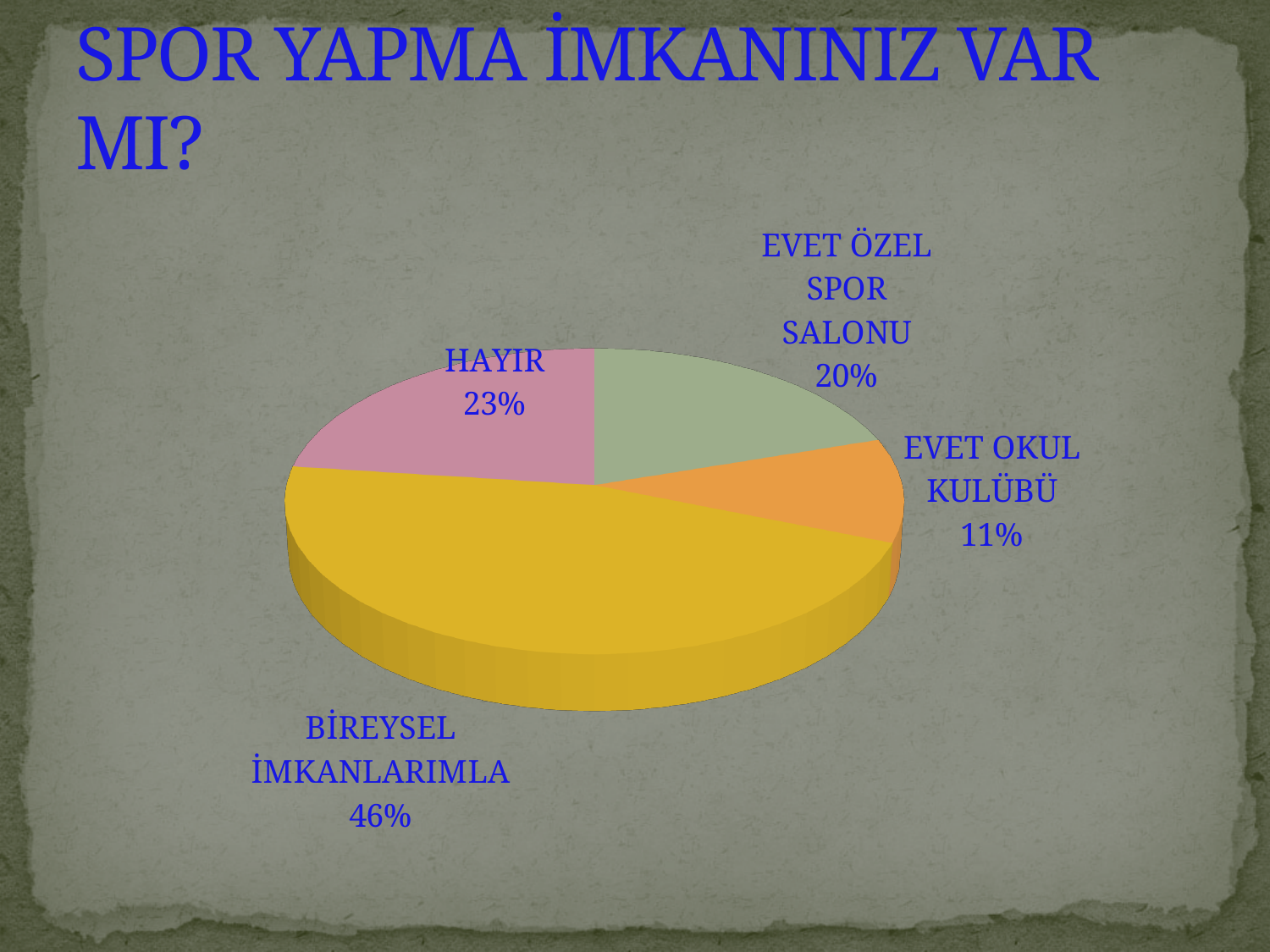
What is the value for EVET OKUL KULÜBÜ? 11% Which category has the smallest slice of the pie? EVET OKUL KULÜBÜ Which category has the largest slice of the pie? BİREYSEL İMKANLARIMLA What is the difference between the values for EVET ÖZEL SPOR SALONU and EVET OKUL KULÜBÜ? 9% What is the value for HAYIR? 23% What is the difference between the values for BİREYSEL İMKANLARIMLA and HAYIR? 23% What share of the pie does BİREYSEL İMKANLARIMLA have? 46% What is the value for EVET ÖZEL SPOR SALONU? 20% What is the title of the slide containing the chart? SPOR YAPMA İMKANINIZ VAR MI? Which is larger, HAYIR or EVET OKUL KULÜBÜ? HAYIR What kind of chart is shown on the slide? pie chart How many slices does the pie chart have? 4